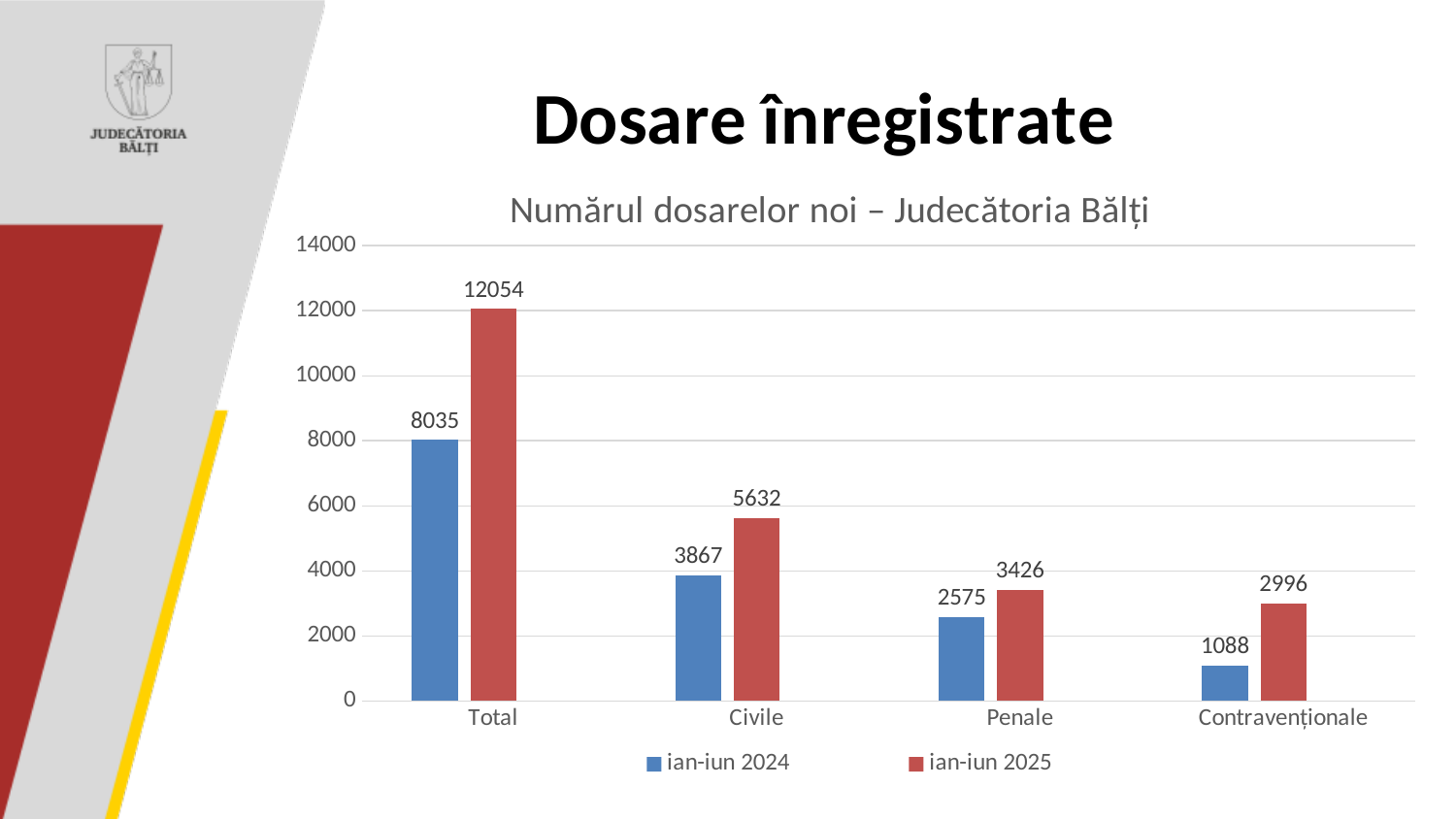
What is the title of the chart? Numărul dosarelor noi – Judecătoria Bălți What kind of chart is shown on the slide? bar chart How many series does the legend list? 2 Which category has the highest value in the ian-iun 2025 series? Total Which is larger for Civile: the ian-iun 2024 value or the ian-iun 2025 value? ian-iun 2025 What is the difference between the ian-iun 2025 and ian-iun 2024 values for Penale? 851 What is the value for Contravenționale in the ian-iun 2024 series? 1088 What is the difference between the ian-iun 2025 and ian-iun 2024 values for Total? 4019 What is the value for Civile in the ian-iun 2025 series? 5632 What is the value for Penale in the ian-iun 2024 series? 2575 How many categories are shown on the x axis? 4 Which category has the lowest value in the ian-iun 2024 series? Contravenționale